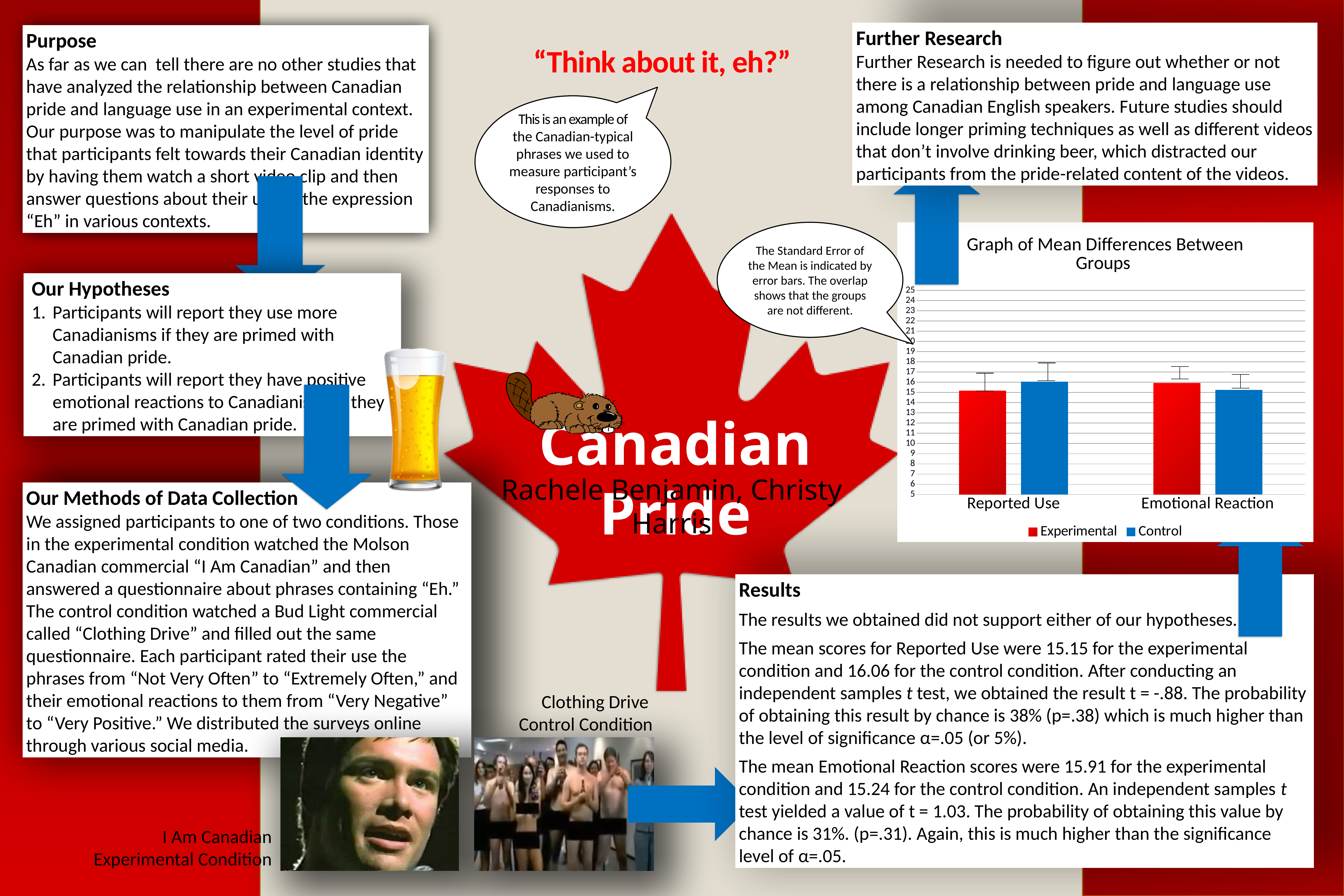
In the "Graph of Mean Differences Between Groups" chart, is the Control value for Emotional Reaction greater or less than 20? less How many categories are shown on the x axis of the "Graph of Mean Differences Between Groups" chart? 2 In the "Graph of Mean Differences Between Groups" chart, is the Experimental value for Reported Use greater or less than 20? less In the "Graph of Mean Differences Between Groups" chart, is the Experimental value for Emotional Reaction greater or less than 10? greater What is the title of the chart on the slide? Graph of Mean Differences Between Groups In the "Graph of Mean Differences Between Groups" chart, which series has the taller bar for Reported Use, Experimental or Control? Control How many series does the legend of the "Graph of Mean Differences Between Groups" chart list? 2 What is the highest value shown on the y axis of the "Graph of Mean Differences Between Groups" chart? 25 What kind of chart is shown under the title "Graph of Mean Differences Between Groups"? bar chart In the "Graph of Mean Differences Between Groups" chart, what colour are the Experimental bars? red In the "Graph of Mean Differences Between Groups" chart, which series has the taller bar for Emotional Reaction, Experimental or Control? Experimental